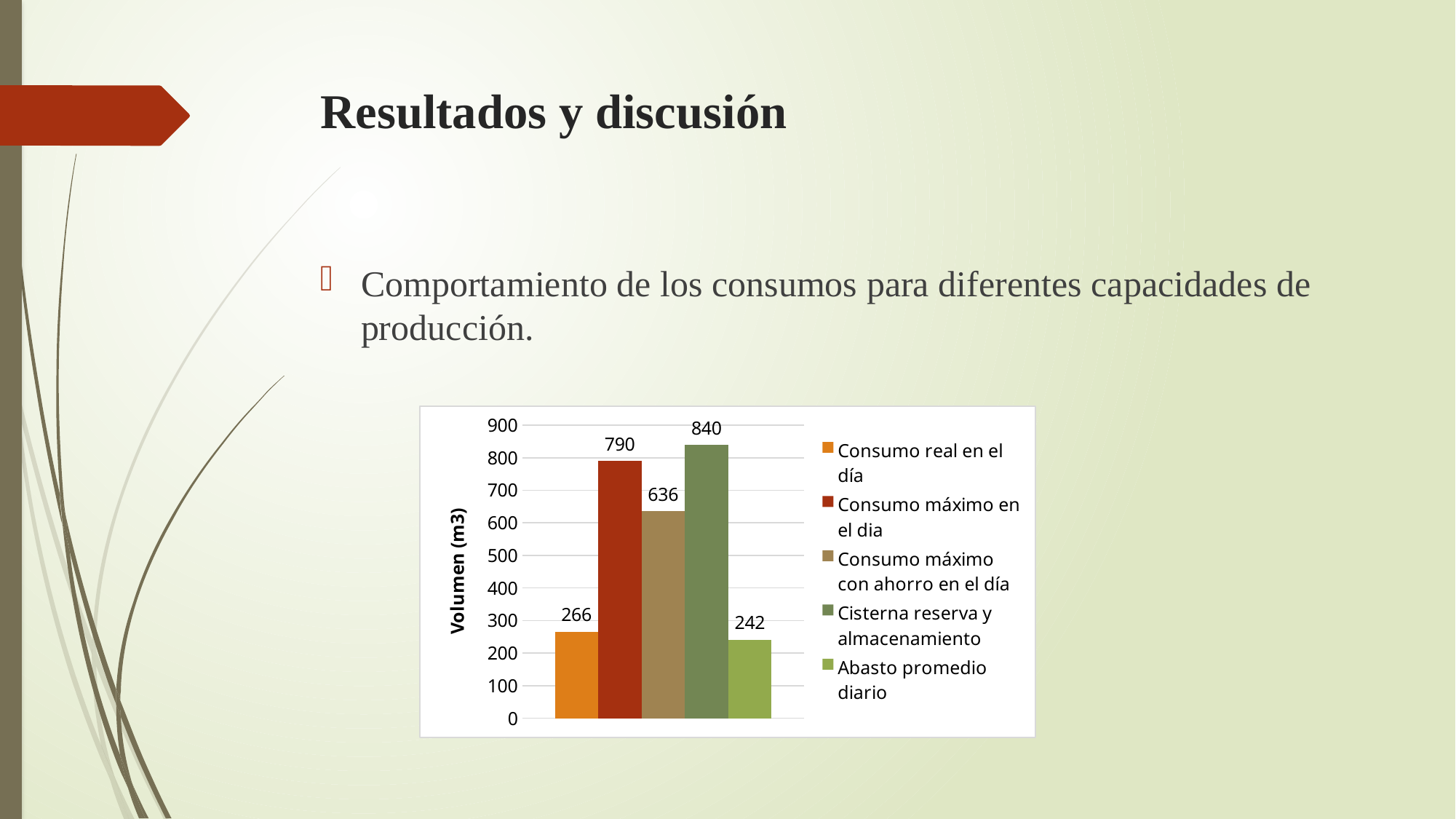
Which series has the lowest value? Abasto promedio diario How many series does the legend list? 5 What is the value for Cisterna reserva y almacenamiento? 840 What kind of chart is shown on the slide? Bar chart Which series has the highest value? Cisterna reserva y almacenamiento What is the value for Consumo máximo en el dia? 790 What is the value for Abasto promedio diario? 242 What is the value for Consumo real en el día? 266 What is the difference between Cisterna reserva y almacenamiento and Consumo máximo en el dia? 50 What is the value for Consumo máximo con ahorro en el día? 636 Which is larger, Consumo real en el día or Abasto promedio diario? Consumo real en el día What is the label of the vertical axis? Volumen (m3)